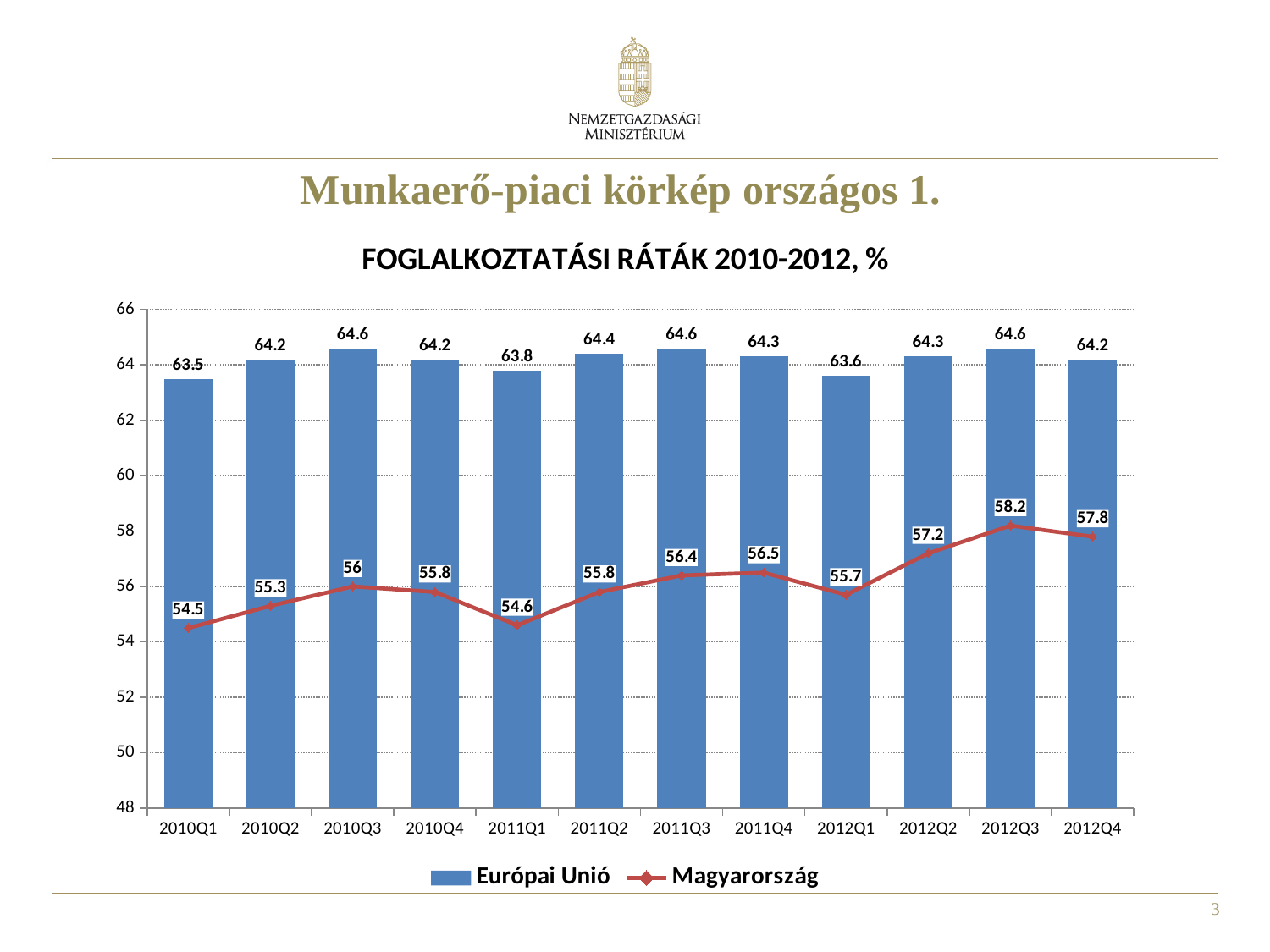
What is the difference between the Magyarország values in 2012Q3 and 2010Q1? 3.7 Which is larger for Európai Unió: the value in 2010Q3 or in 2011Q1? 2010Q3 Is the value for Magyarország in 2010Q1 greater or less than 56? less Does the Magyarország line rise or fall from 2012Q1 to 2012Q3? rise What is the value for Magyarország in 2012Q3? 58.2 In which quarter does Magyarország reach its highest value? 2012Q3 How many series does the legend list? 2 What kind of chart is shown on the slide? Combined bar and line chart What is the value for Magyarország in 2011Q1? 54.6 What is the difference between the Európai Unió and Magyarország values in 2012Q4? 6.4 How many quarters are shown on the x axis? 12 What is the value for Európai Unió in 2010Q1? 63.5